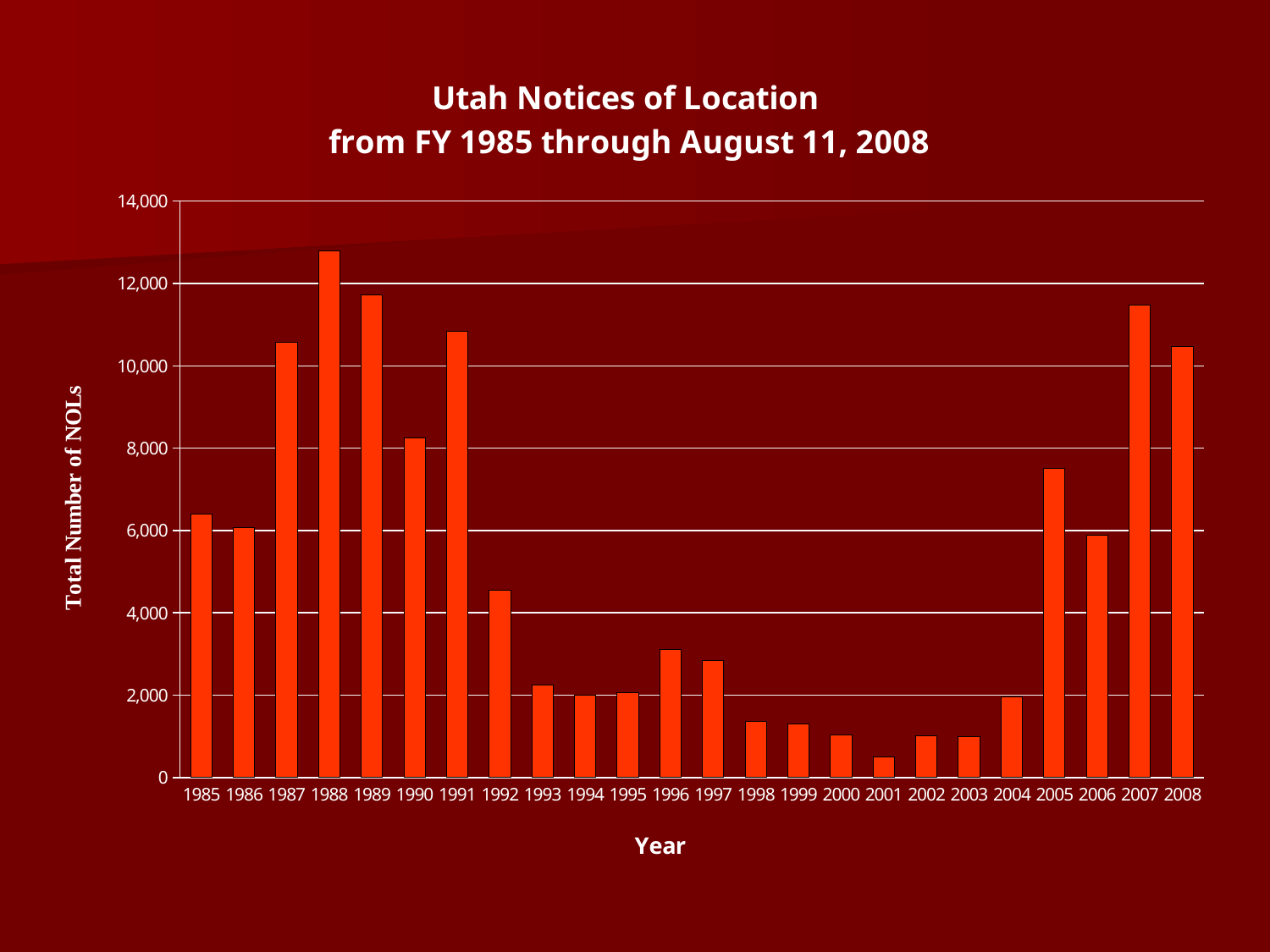
Which year has the larger value, 2007 or 2006? 2007 What is the label on the y axis? Total Number of NOLs Is the value for 1988 greater or less than 12,000? greater How many years are shown on the x axis? 24 Which year has the lowest total number of NOLs? 2001 Do the values rise or fall from 1997 to 2001? fall Is the value for 2005 greater or less than 6,000? greater What kind of chart is shown on the slide? bar chart Is the value for 2001 greater or less than 2,000? less Which year has the highest total number of NOLs? 1988 Which year has the larger value, 1989 or 1990? 1989